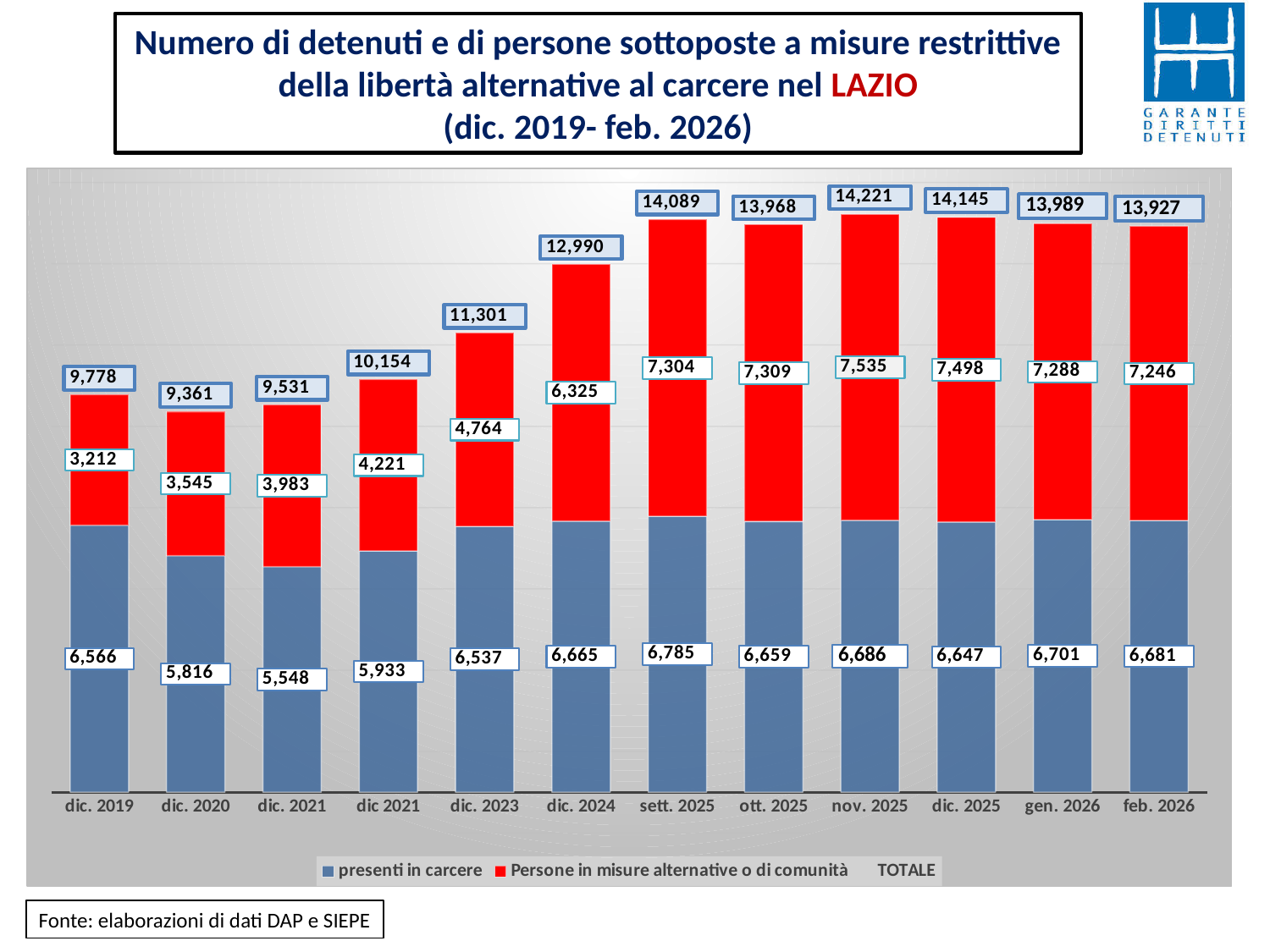
How many entries does the legend list? 3 Which period has the lowest TOTALE value? dic. 2020 Does the 'Persone in misure alternative o di comunità' value generally rise or fall from dic. 2019 to nov. 2025? rise What is the TOTALE value for dic. 2024? 12,990 What is the difference between the TOTALE for nov. 2025 and the TOTALE for dic. 2019? 4,443 Which is larger for sett. 2025: 'presenti in carcere' or 'Persone in misure alternative o di comunità'? Persone in misure alternative o di comunità What type of chart is shown on the slide? stacked bar chart What is the value of 'Persone in misure alternative o di comunità' for feb. 2026? 7,246 How many time periods (categories) are shown on the x axis? 12 Which period has the highest TOTALE value? nov. 2025 Which region is named in the chart title? LAZIO What is the value of 'presenti in carcere' for dic. 2019? 6,566